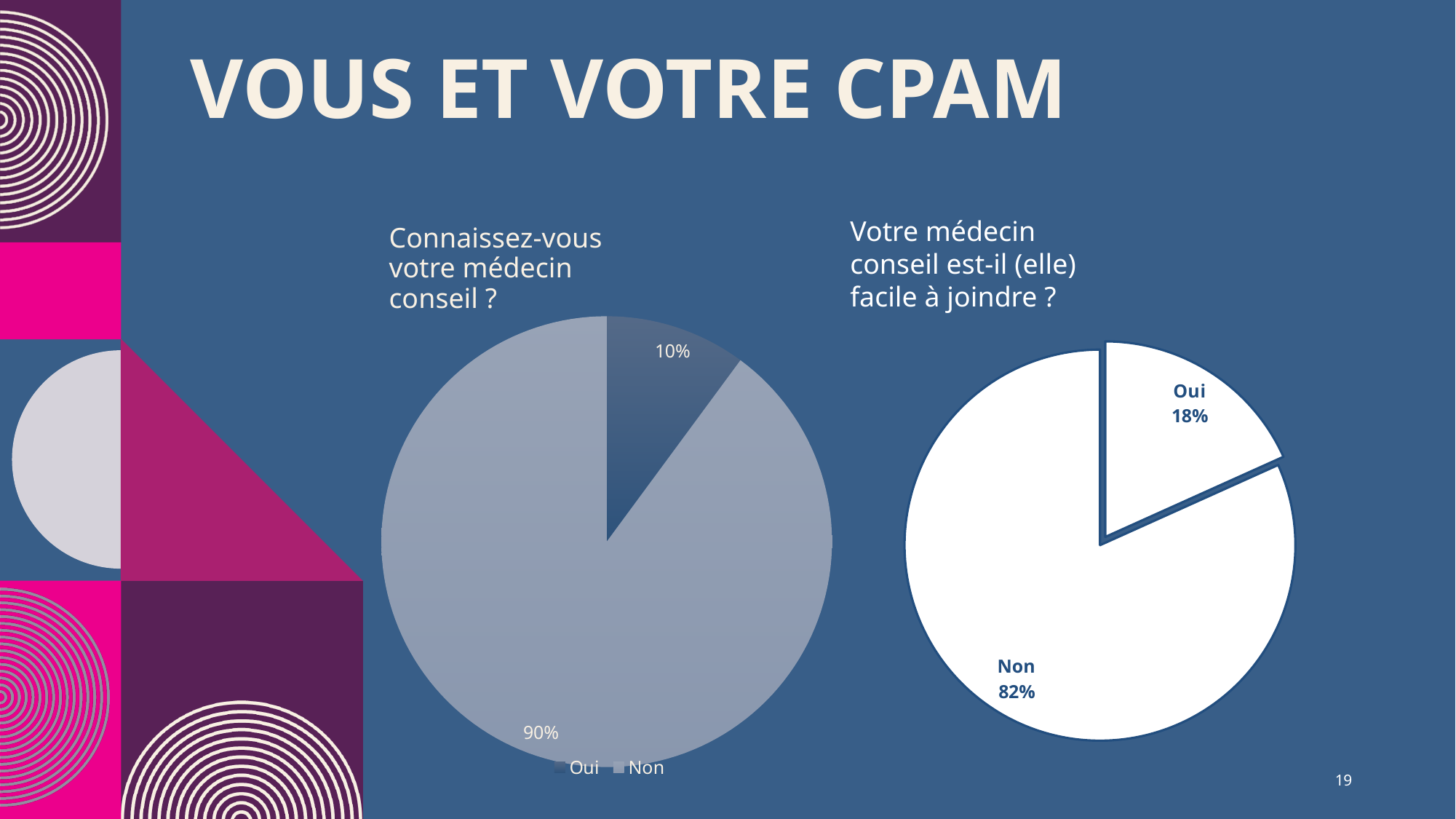
What type of chart is used for "Votre médecin conseil est-il (elle) facile à joindre ?"? Pie chart What are the legend entries of the chart titled "Connaissez-vous votre médecin conseil ?"? Oui, Non In the chart titled "Votre médecin conseil est-il (elle) facile à joindre ?", what percentage answered Oui? 18% In the chart titled "Votre médecin conseil est-il (elle) facile à joindre ?", what is the difference between the Non and Oui percentages? 64% In the chart titled "Connaissez-vous votre médecin conseil ?", what percentage answered Oui? 10% How many categories does the chart titled "Connaissez-vous votre médecin conseil ?" show? 2 In the chart titled "Connaissez-vous votre médecin conseil ?", what is the difference between the Non and Oui percentages? 80% Which is larger: the Oui share in the left chart ("Connaissez-vous votre médecin conseil ?") or the Oui share in the right chart ("Votre médecin conseil est-il (elle) facile à joindre ?")? The right chart (18%) In the chart titled "Votre médecin conseil est-il (elle) facile à joindre ?", what percentage answered Non? 82% In the chart titled "Connaissez-vous votre médecin conseil ?", what percentage answered Non? 90% In the chart titled "Connaissez-vous votre médecin conseil ?", which category has the largest slice? Non In the chart titled "Votre médecin conseil est-il (elle) facile à joindre ?", which category has the smallest slice? Oui